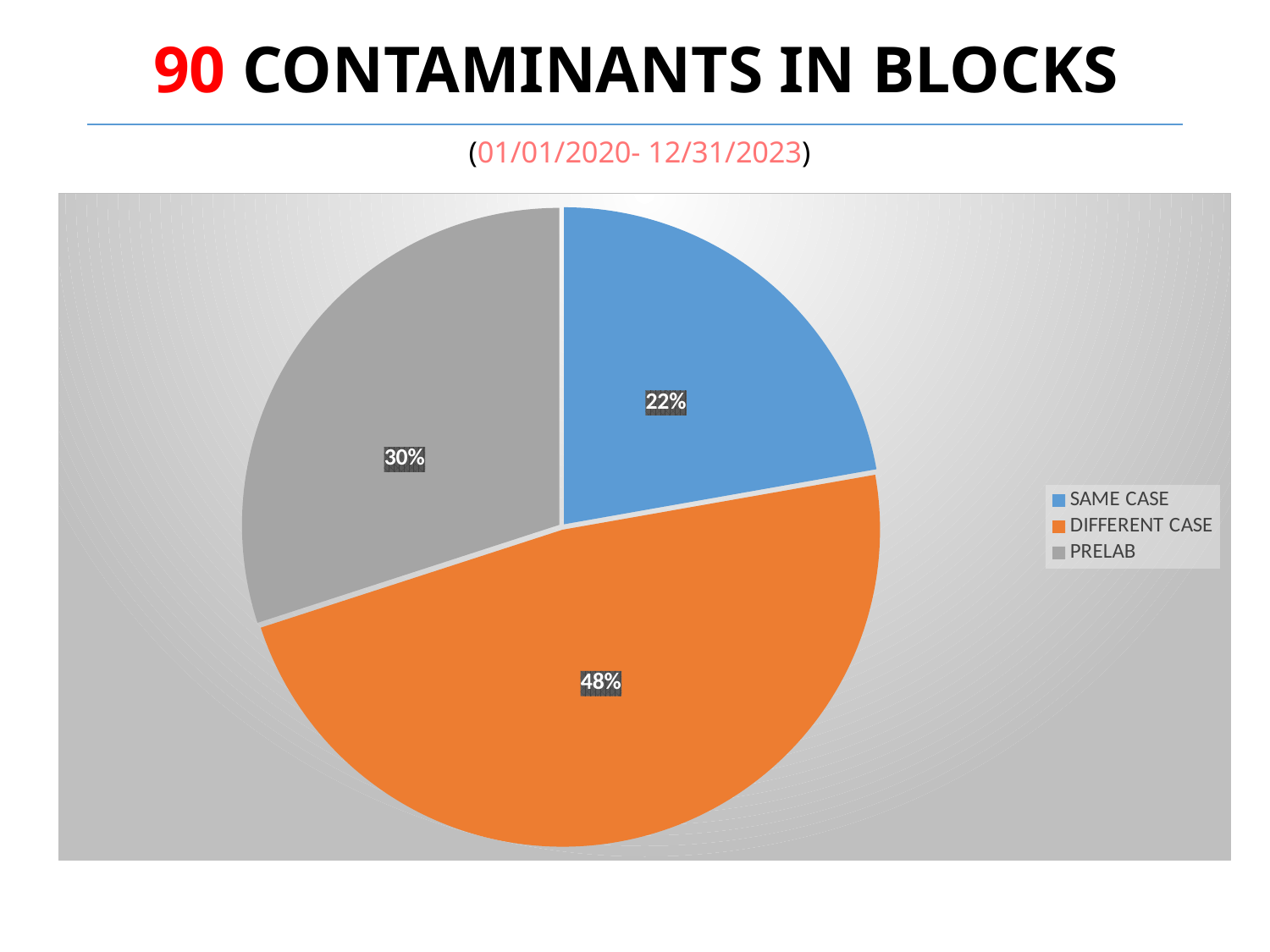
What colour is the DIFFERENT CASE slice? orange What date range is shown under the slide title? 01/01/2020- 12/31/2023 What share of the pie does PRELAB represent? 30% Which category has the smallest slice of the pie? SAME CASE Which is larger, the PRELAB slice or the SAME CASE slice? PRELAB How many categories does the pie chart have? 3 Which category has the largest slice of the pie? DIFFERENT CASE What is the difference in percentage points between PRELAB and SAME CASE? 8 What kind of chart is shown on the slide? pie chart What share of the pie does DIFFERENT CASE represent? 48% What share of the pie does SAME CASE represent? 22% What is the difference in percentage points between DIFFERENT CASE and PRELAB? 18